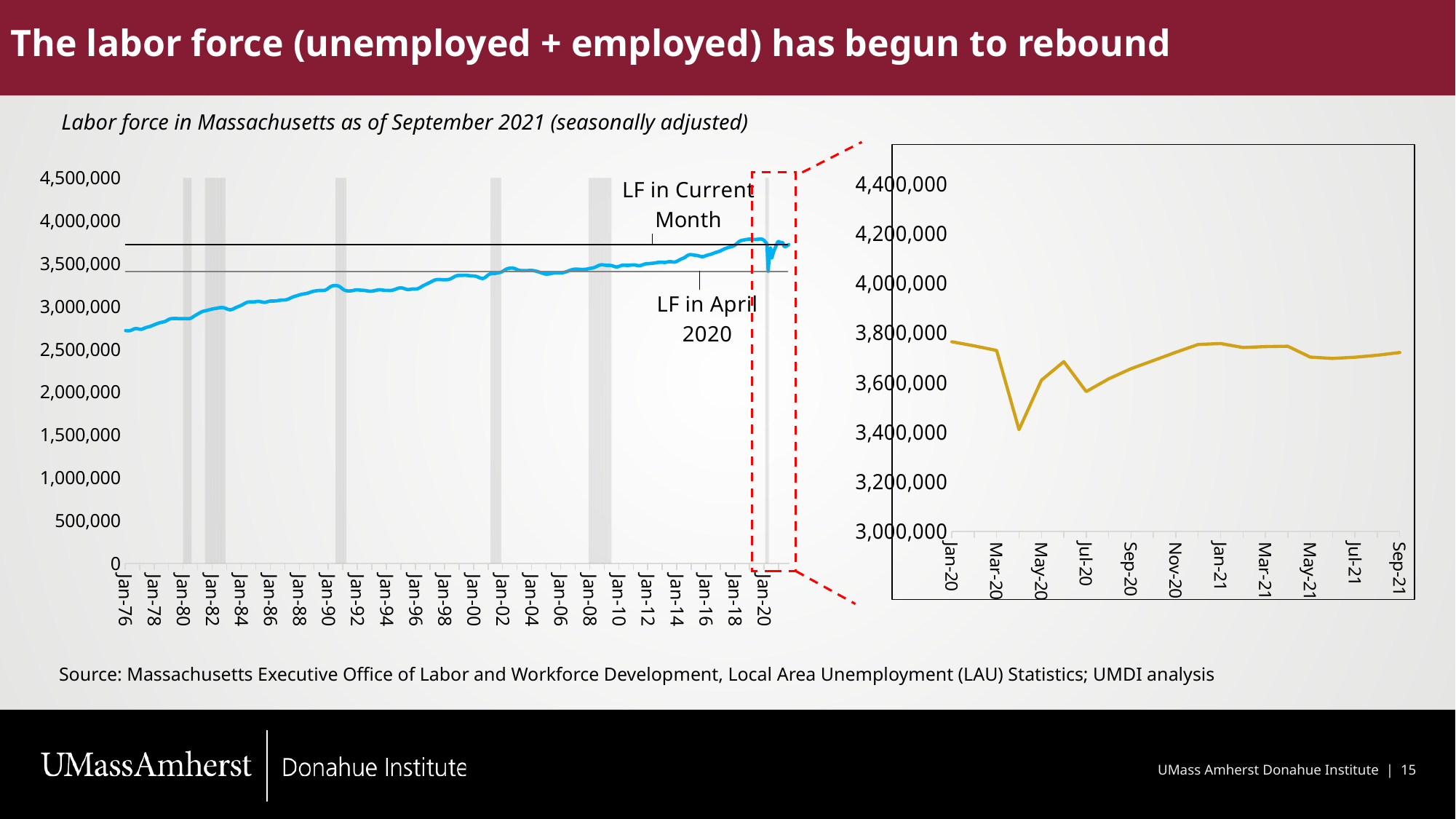
In the inset chart on the right, does the line rise or fall between Mar-20 and May-20? fall In the inset chart on the right, which is larger, the value at Jul-20 or the value at Jan-21? Jan-21 In the left chart, does the labor force generally rise or fall from Jan-76 to Jan-20? rise What are the two horizontal reference lines in the left chart labeled? LF in Current Month and LF in April 2020 What is the subtitle printed above the left chart? Labor force in Massachusetts as of September 2021 (seasonally adjusted) In the left chart, is the labor force value at Jan-76 greater or less than 3,000,000? less In the inset chart on the right, is the value at Jan-20 greater or less than 3,600,000? greater In the inset chart on the right, is the lowest point of the line greater or less than 3,600,000? less What kind of chart is the inset chart on the right covering Jan-20 to Sep-21? line chart What kind of chart is the left chart showing the labor force from Jan-76 to Sep-21? line chart